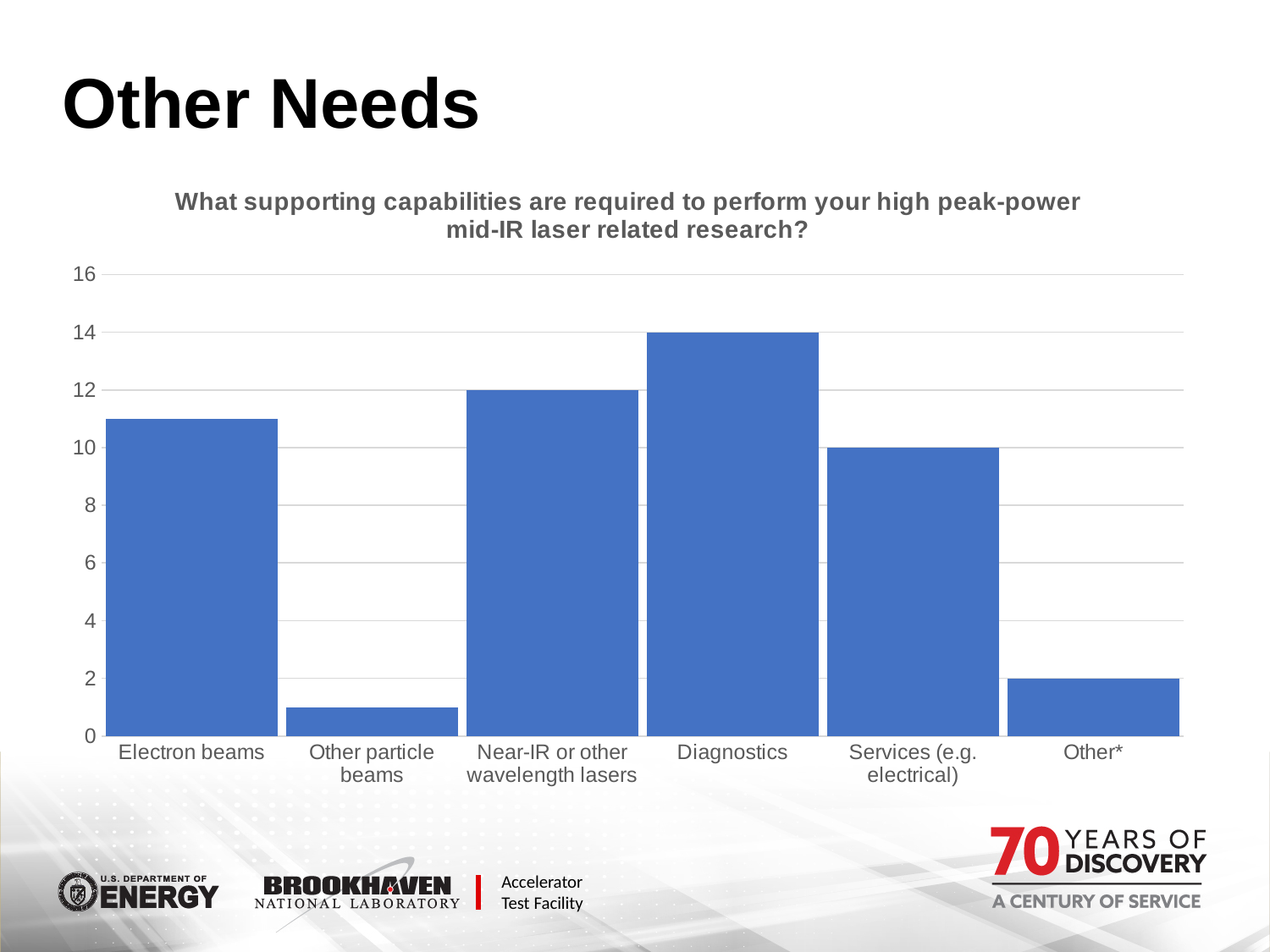
What is the value for Diagnostics? 14 Is the value for Other particle beams greater or less than 2? less Which is larger, the value for Electron beams or the value for Near-IR or other wavelength lasers? Near-IR or other wavelength lasers What is the value for Near-IR or other wavelength lasers? 12 Is the value for Electron beams greater or less than 10? greater What is the difference between the values for Diagnostics and Services (e.g. electrical)? 4 What type of chart is shown on the slide? bar chart What is the value for Other*? 2 Which category has the highest value in the chart? Diagnostics How many categories are shown on the x axis of the chart? 6 Which category has the lowest value in the chart? Other particle beams What is the value for Services (e.g. electrical)? 10